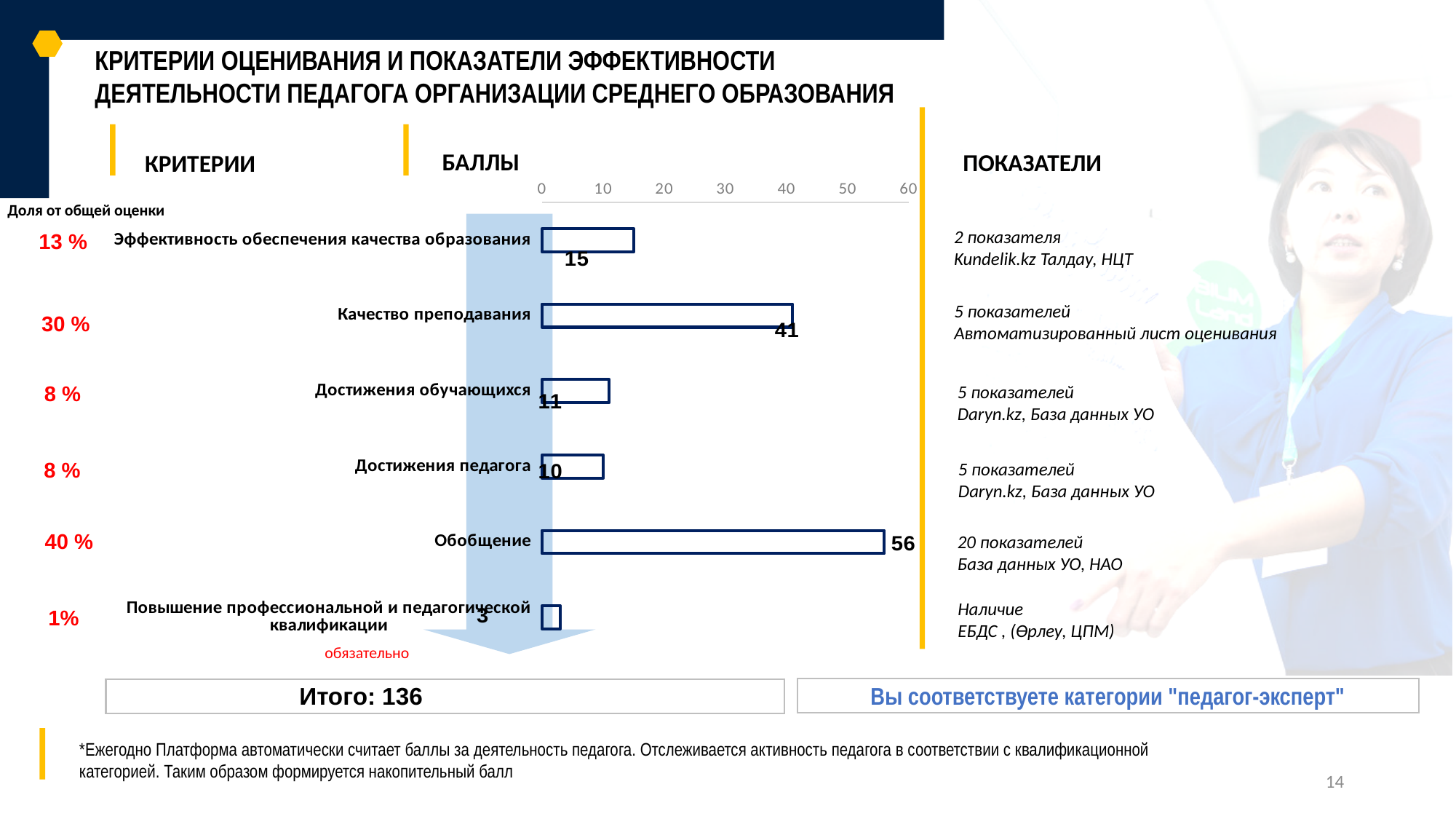
What is the value for Эффективность обеспечения качества образования? 15 Which is larger, the value for Достижения обучающихся or the value for Достижения педагога? Достижения обучающихся What is the difference between the values for Обобщение and Качество преподавания? 15 Is the value for Качество преподавания greater or less than 40? greater What kind of chart is shown on the slide? bar chart What is the value for Качество преподавания? 41 What is the highest tick value shown on the horizontal axis of the chart? 60 What is the value for Обобщение? 56 Which category has the highest value? Обобщение What is the value for Повышение профессиональной и педагогической квалификации? 3 How many categories does the bar chart show? 6 Which category has the lowest value? Повышение профессиональной и педагогической квалификации